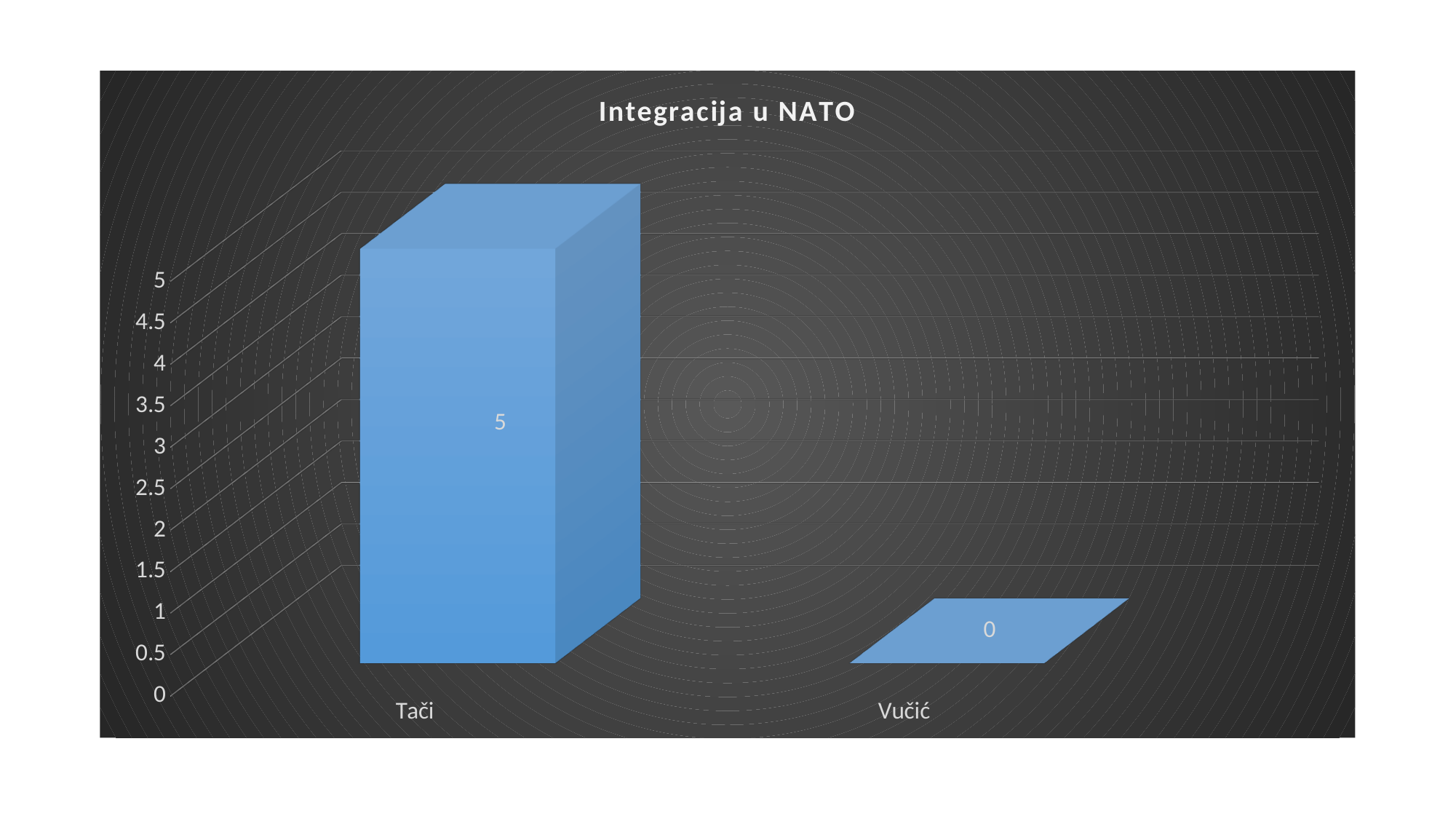
What is the title of the chart? Integracija u NATO What is the value for Tači? 5 What is the difference between the values for Tači and Vučić? 5 What is the value for Vučić? 0 What kind of chart is shown on the slide? bar chart How many categories are shown on the x axis? 2 Do the values rise or fall from Tači to Vučić? fall What is the highest value shown on the vertical axis? 5 Which category has the lowest value? Vučić Is the value for Tači greater or less than 3? greater Which is larger, the value for Tači or the value for Vučić? Tači Which category has the highest value? Tači